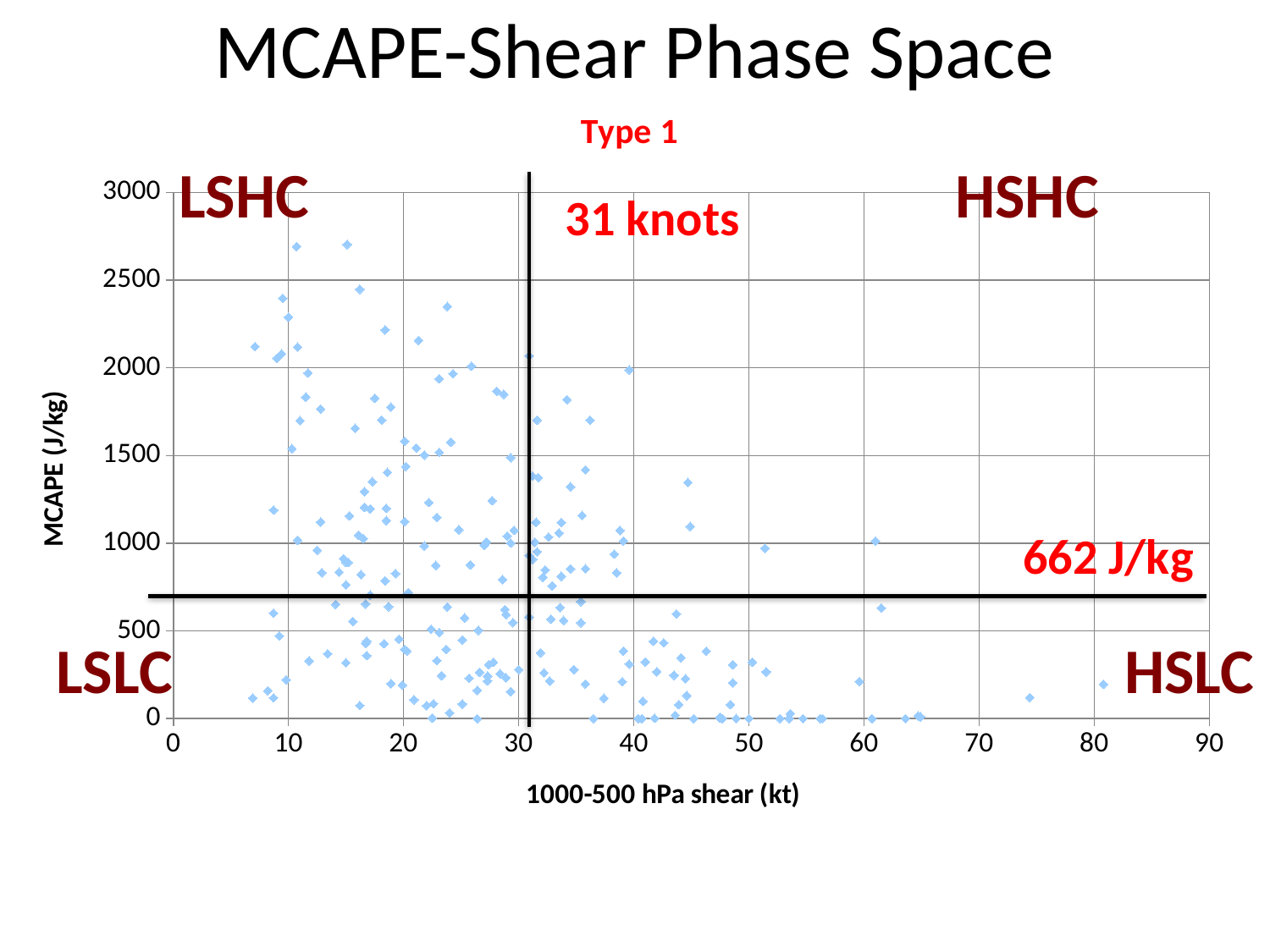
What is the maximum value shown on the y axis? 3000 What shear value does the vertical black line mark? 31 knots What is the title of the chart? Type 1 What is the label of the x axis? 1000-500 hPa shear (kt) What kind of chart is shown on the slide? scatter plot What is the label of the y axis? MCAPE (J/kg) Is the highest plotted MCAPE value greater or less than 2500? greater Which quadrant label appears in the upper-left region of the chart? LSHC What is the maximum value shown on the x axis? 90 Which quadrant label appears in the lower-right region of the chart? HSLC What MCAPE value does the horizontal black line mark? 662 J/kg